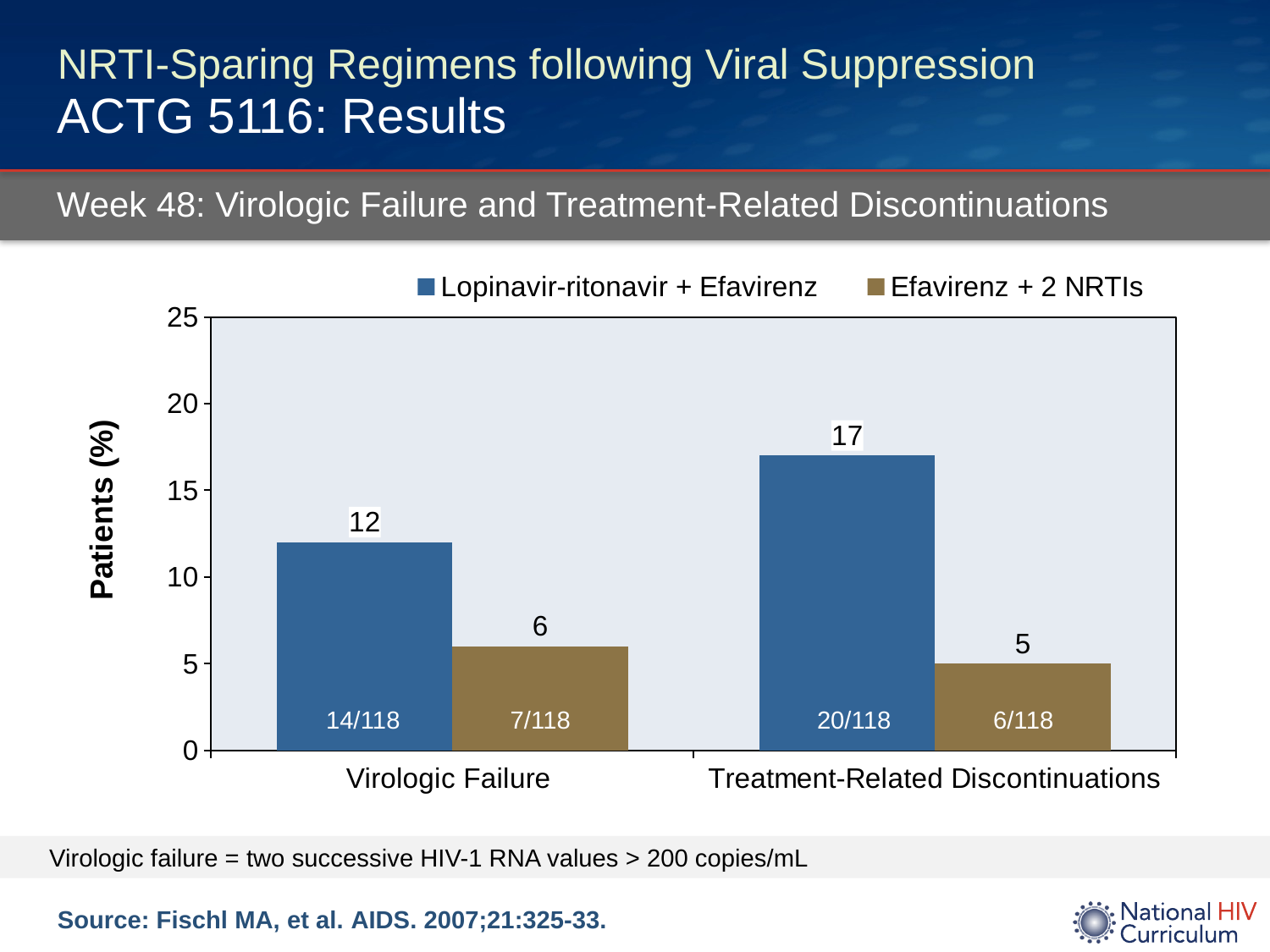
How many categories are shown on the x axis? 2 What is the value for Efavirenz + 2 NRTIs in the Virologic Failure category? 6 What is the difference between the two series' values for Virologic Failure? 6 What is the difference between the Lopinavir-ritonavir + Efavirenz and Efavirenz + 2 NRTIs values for Treatment-Related Discontinuations? 12 Which series has the highest value in the Treatment-Related Discontinuations category? Lopinavir-ritonavir + Efavirenz Which bar has the lowest value on the chart? Efavirenz + 2 NRTIs, Treatment-Related Discontinuations What is the value for Lopinavir-ritonavir + Efavirenz in the Virologic Failure category? 12 What fraction of patients is printed on the Lopinavir-ritonavir + Efavirenz bar for Treatment-Related Discontinuations? 20/118 How many series does the legend list? 2 What is the value for Efavirenz + 2 NRTIs in the Treatment-Related Discontinuations category? 5 What kind of chart is shown on the slide? Bar chart Which is larger: the Lopinavir-ritonavir + Efavirenz value for Virologic Failure or for Treatment-Related Discontinuations? Treatment-Related Discontinuations